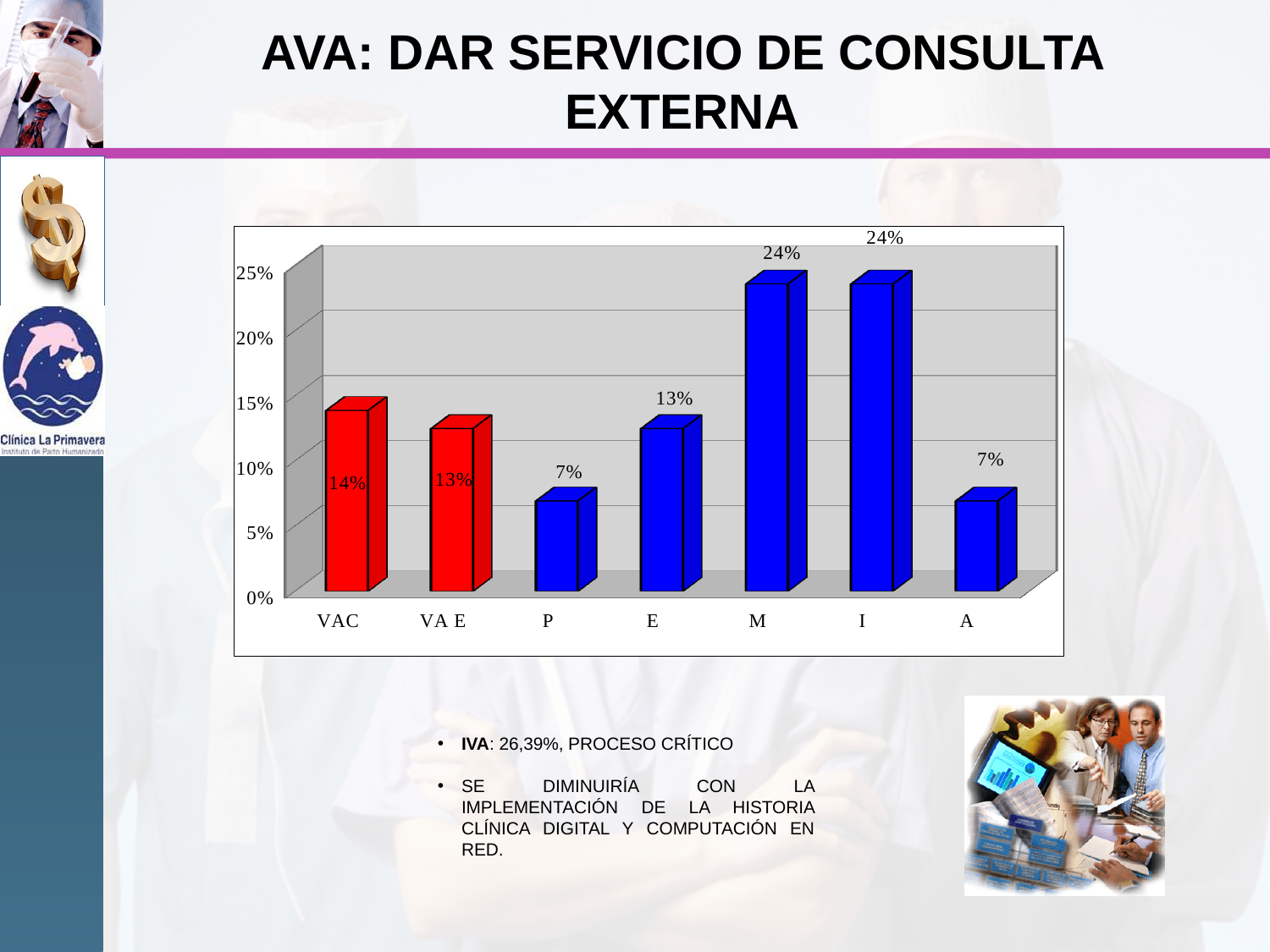
What is the difference between the values for M and VAC? 10% How many categories are shown on the x axis? 7 What is the difference between the values for VAC and P? 7% What colour are the bars for VAC and VA E? red What is the value for A? 7% Which is larger, the value for VAC or the value for VA E? VAC Which categories share the highest value in the chart? M and I What is the value for E? 13% What kind of chart is shown on the slide? bar chart What is the value for VAC? 14% Is the value for I greater or less than 20%? greater What is the value for M? 24%